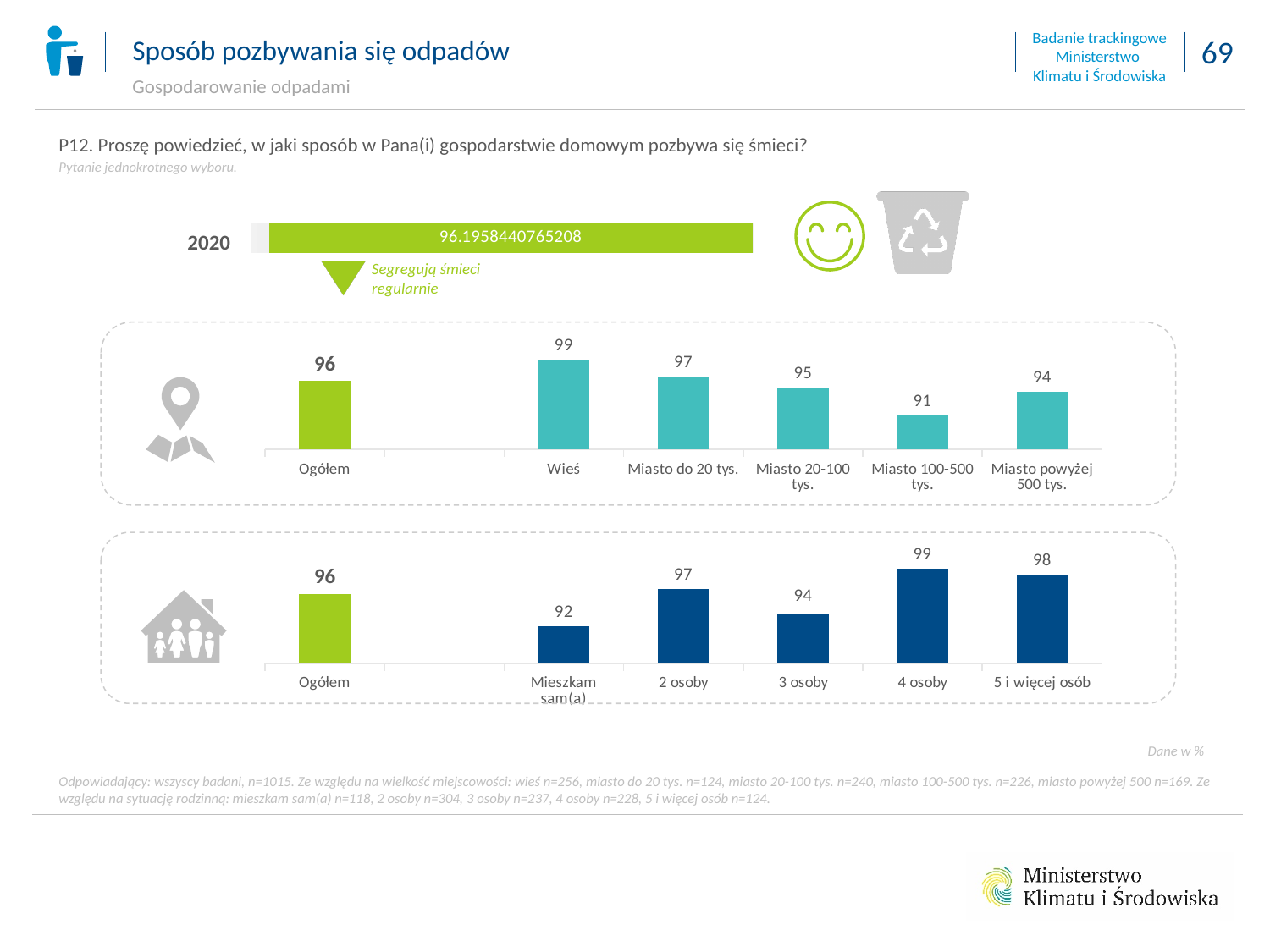
In the bottom chart (by household size), which is larger: 2 osoby or 3 osoby? 2 osoby In the middle chart (by locality size), which category has the lowest value? Miasto 100-500 tys. In the bottom chart (by household size), what is the value for Mieszkam sam(a)? 92 In the bottom chart (by household size), which category has the highest value? 4 osoby In the middle chart (by locality size), which category has the highest value? Wieś How many bars are shown in the bottom chart (by household size), including Ogółem? 6 What value is printed on the green 2020 bar at the top of the slide? 96.1958440765208 In the middle chart (by locality size), what is the value for Miasto 100-500 tys.? 91 In the middle chart (by locality size), what is the difference between Wieś and Miasto 100-500 tys.? 8 In the bottom chart (by household size), what is the difference between 4 osoby and Mieszkam sam(a)? 7 What type of chart is used in the middle section (by locality size)? Bar chart In the middle chart (by locality size), what is the value for Wieś? 99